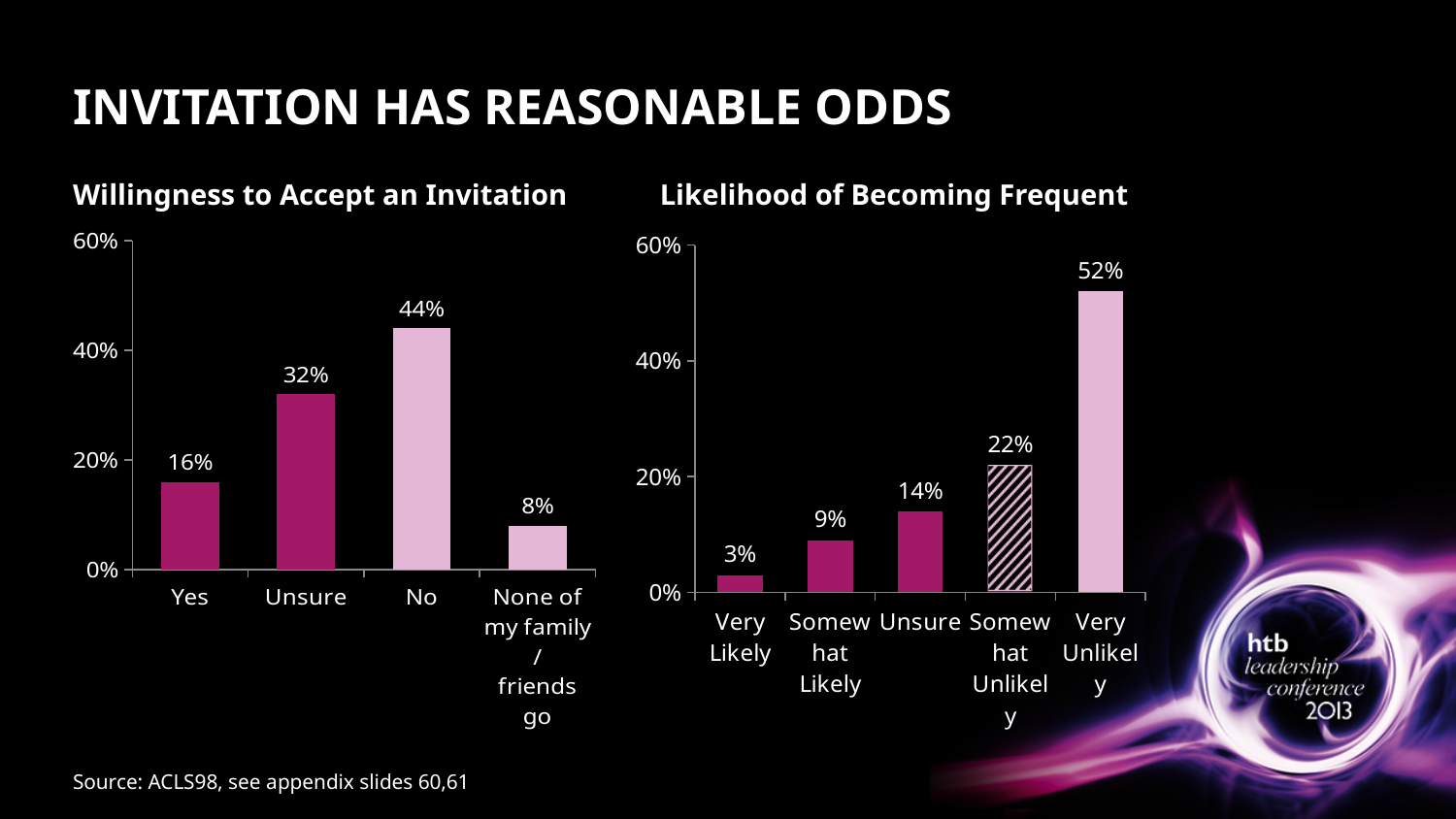
In the 'Willingness to Accept an Invitation' chart, which category has the lowest value? None of my family / friends go What kind of chart is the 'Likelihood of Becoming Frequent' chart? bar chart In the 'Willingness to Accept an Invitation' chart, what is the value for 'Unsure'? 32% In the 'Willingness to Accept an Invitation' chart, which category has the highest value? No In the 'Likelihood of Becoming Frequent' chart, which category has the lowest value? Very Likely In the 'Likelihood of Becoming Frequent' chart, what is the difference between the values for 'Very Unlikely' and 'Very Likely'? 49% In the 'Willingness to Accept an Invitation' chart, what is the difference between the values for 'No' and 'Yes'? 28% In the 'Willingness to Accept an Invitation' chart, how many categories are shown? 4 In the 'Likelihood of Becoming Frequent' chart, do the values rise or fall from left to right along the x axis? rise In the 'Likelihood of Becoming Frequent' chart, which is larger, the value for 'Unsure' or the value for 'Somewhat Likely'? Unsure In the 'Likelihood of Becoming Frequent' chart, which category has the highest value? Very Unlikely In the 'Likelihood of Becoming Frequent' chart, what is the value for 'Somewhat Unlikely'? 22%